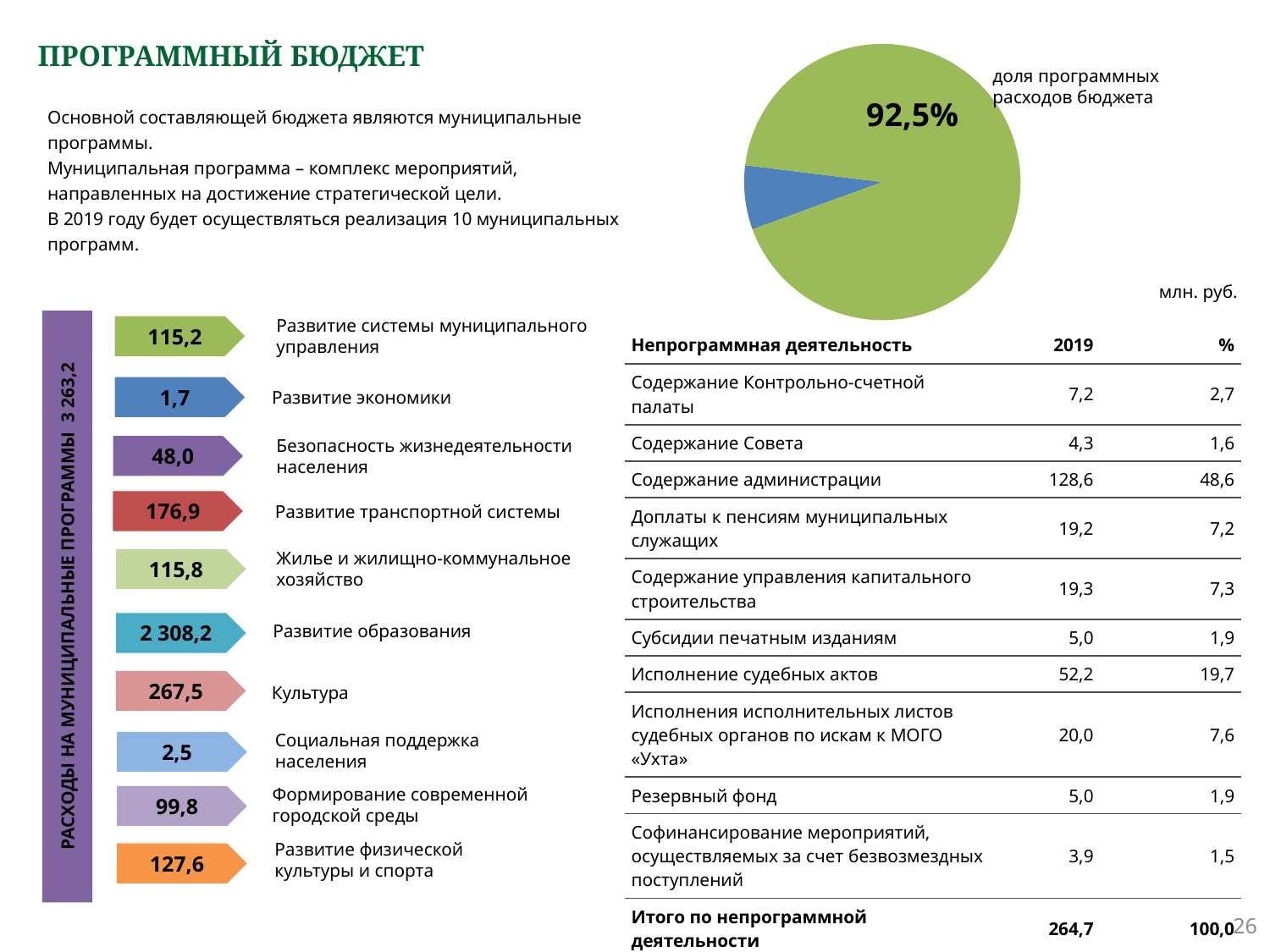
In the pie chart, what share of the budget do programme expenditures (доля программных расходов бюджета) make up? 92,5% What kind of chart is shown at the top right of the slide? pie chart Is the share shown for the green slice of the pie chart greater or less than 90%? greater What label is written next to the pie chart describing what the 92,5% slice represents? доля программных расходов бюджета How many slices does the pie chart have? 2 In the pie chart, which slice is larger, the green one or the blue one? the green one What colour is the slice of the pie chart labelled 92,5%? green